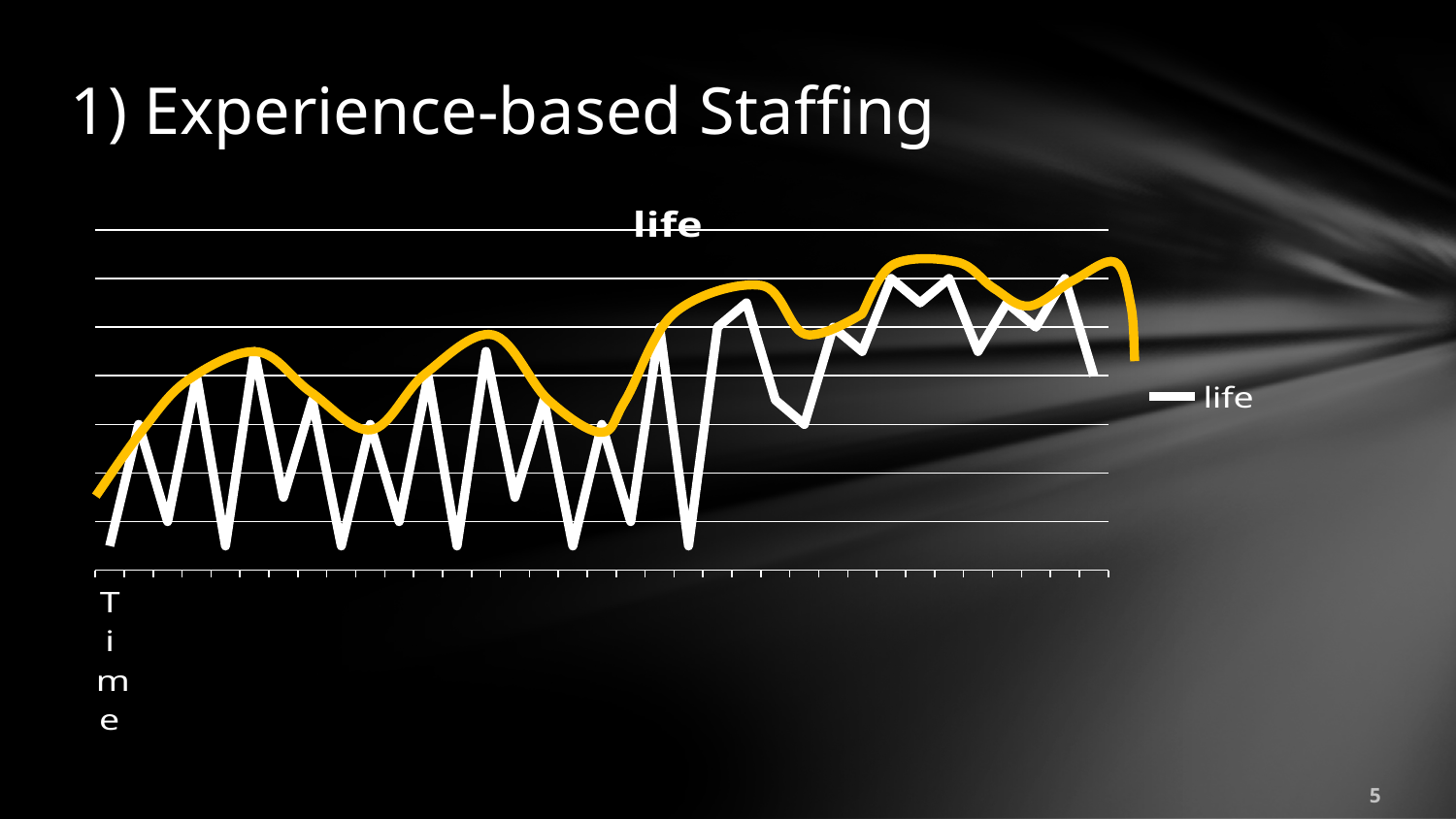
How many series does the chart's legend list? 1 What is the title of the chart? life What label is shown on the horizontal axis of the chart? Time What kind of chart is shown on the slide? line chart What is the name of the series listed in the legend? life Overall, do the values of the 'life' series rise or fall from left to right along the x axis? rise